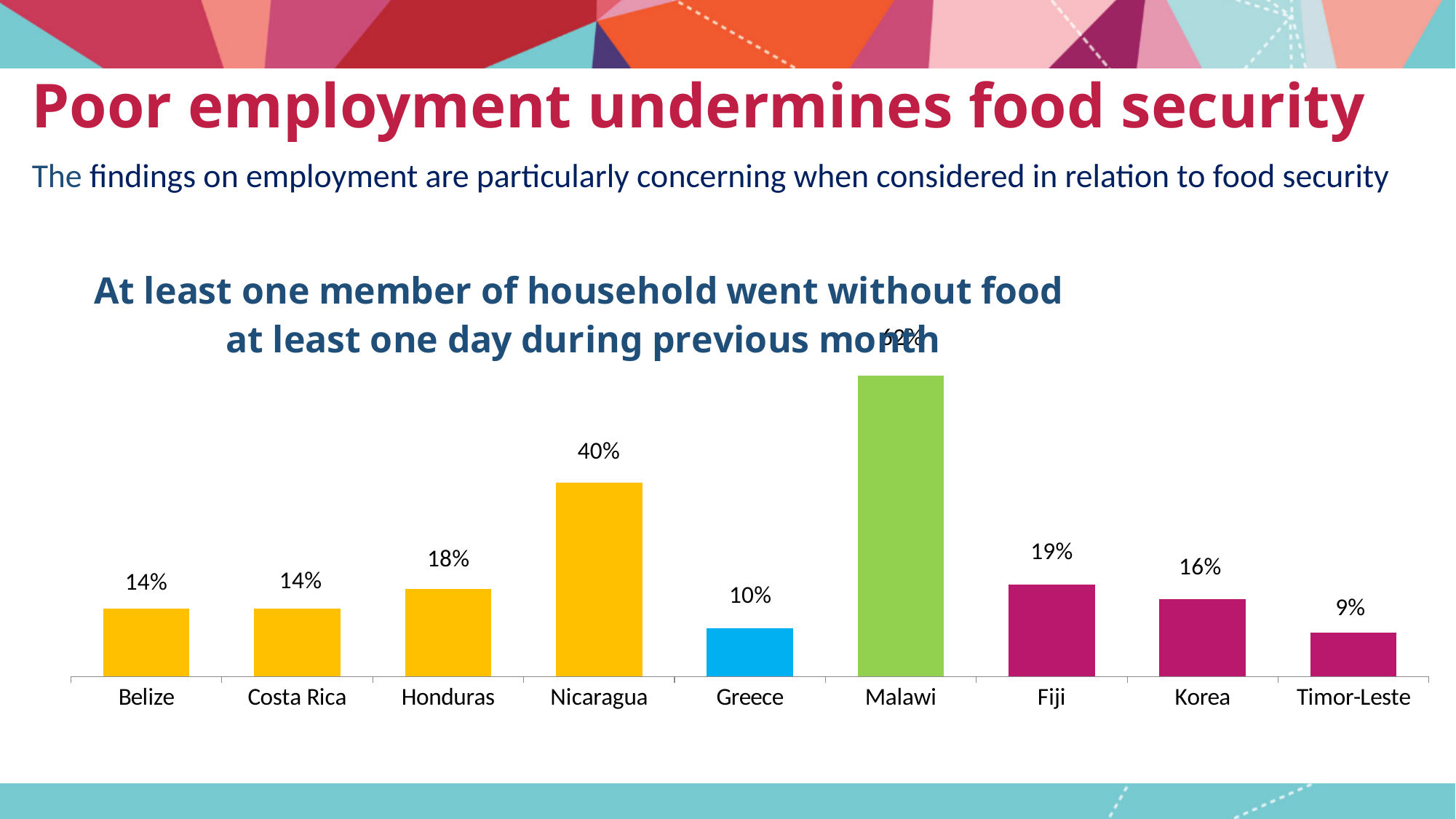
What is the title of the chart? At least one member of household went without food at least one day during previous month Which country has the highest value? Malawi What is the value for Timor-Leste? 9% What is the difference between the values for Fiji and Korea? 3% Which country has the lowest value? Timor-Leste What is the value for Greece? 10% How many countries are shown on the chart? 9 What is the value for Nicaragua? 40% What is the value for Fiji? 19% What is the difference between the values for Nicaragua and Honduras? 22% What kind of chart is shown on the slide? Bar chart Which is larger, the value for Honduras or the value for Korea? Honduras